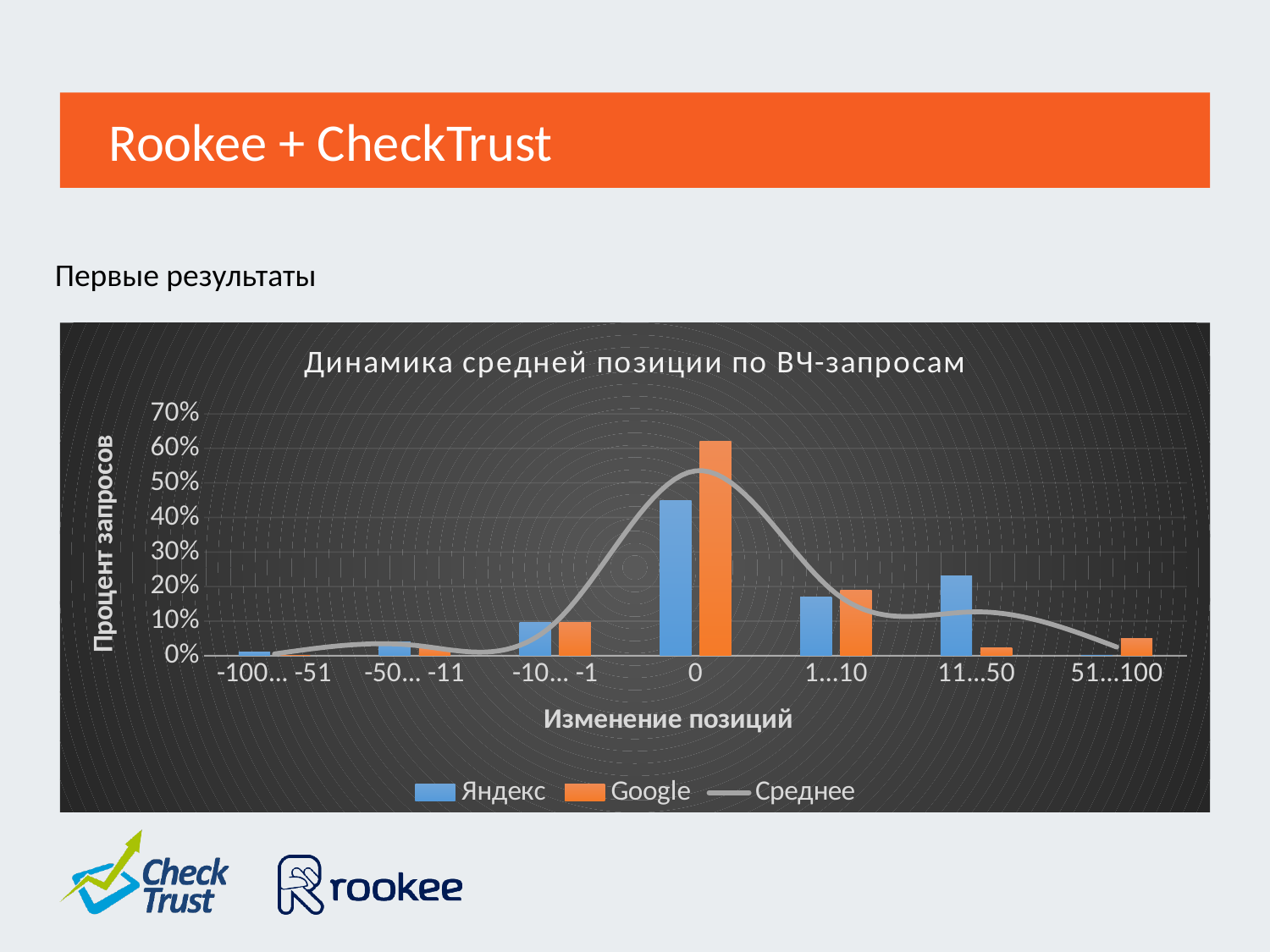
In the category 0, which is larger: Яндекс or Google? Google How many categories are shown on the x axis? 7 Which series is drawn as a line rather than bars? Среднее How many series does the legend list? 3 For which category is the Google value highest? 0 Is the Яндекс value for category 0 greater or less than 50%? less What is the title of the chart? Динамика средней позиции по ВЧ-запросам Is the Google value for category 11…50 greater or less than 10%? less Is the Google value for category 0 greater or less than 50%? greater What kind of chart is shown on the slide? Bar chart with a line For which category is the Яндекс value highest? 0 In the category 11…50, which is larger: Яндекс or Google? Яндекс